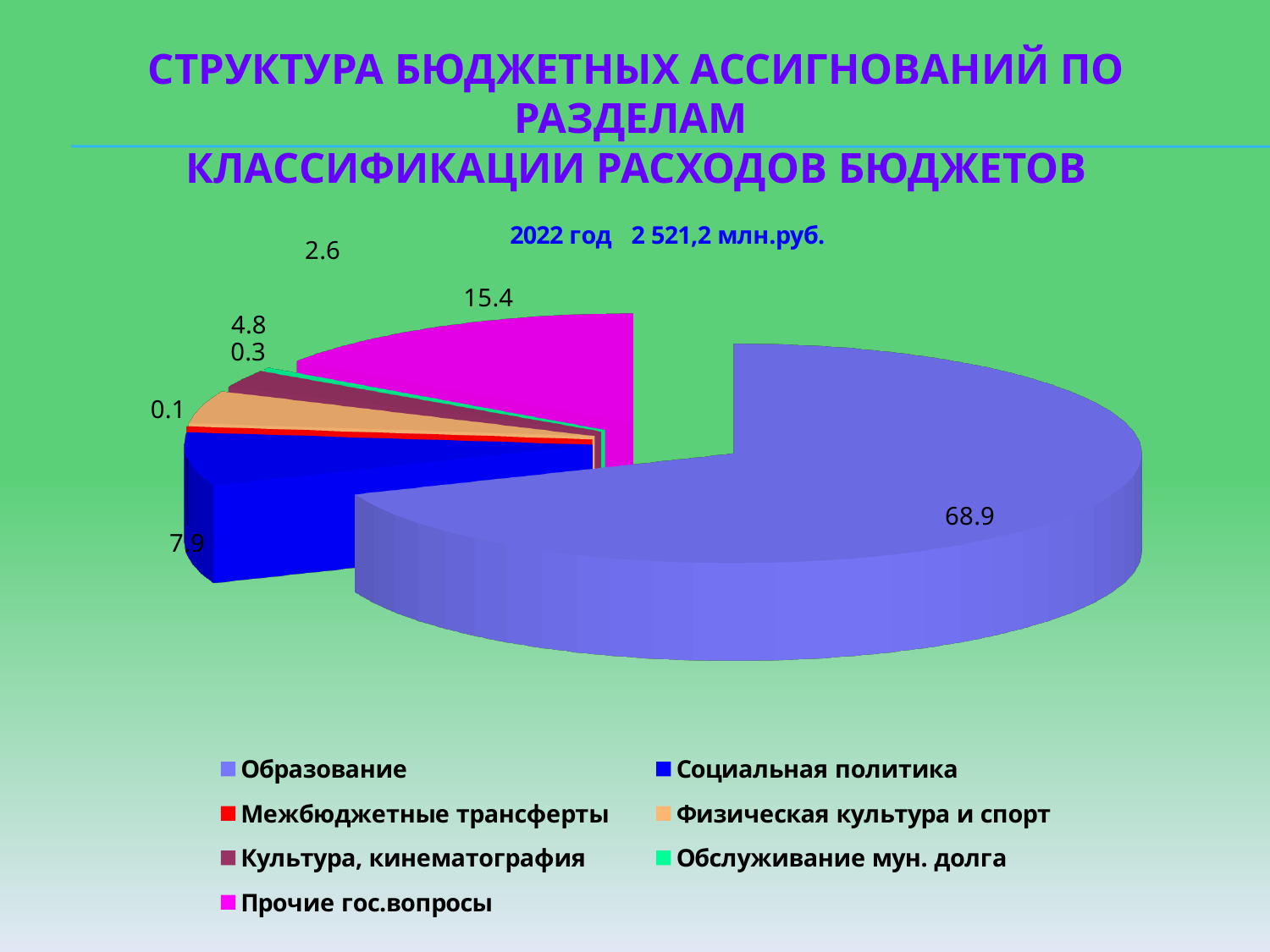
Which category has the largest slice of the pie? Образование What is the difference between the values for Образование and Прочие гос.вопросы? 53.5 What is the value shown for Прочие гос.вопросы? 15.4 What is the value shown for Образование? 68.9 What year and total amount are stated in the chart's subtitle? 2022 год 2 521,2 млн.руб. What kind of chart is shown on the slide? pie chart What is the value shown for Социальная политика? 7.9 Which is larger, the value for Социальная политика or the value for Прочие гос.вопросы? Прочие гос.вопросы What is the value shown for Межбюджетные трансферты? 0.1 How many categories does the legend of the pie chart list? 7 What colour is the slice for Прочие гос.вопросы? magenta Which category has the smallest slice of the pie? Межбюджетные трансферты